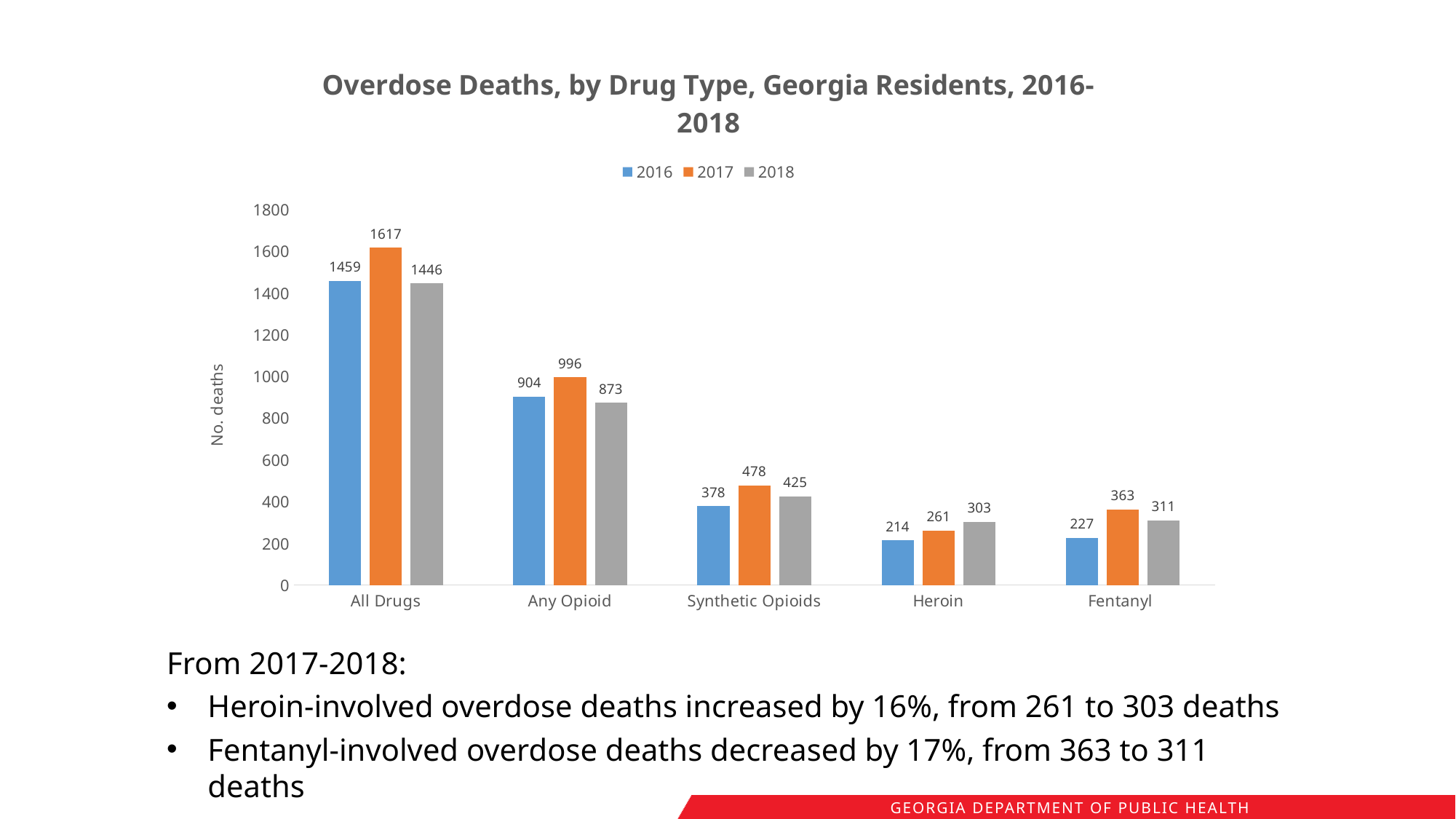
What is the number of overdose deaths for All Drugs in 2017? 1617 Which drug type has the lowest number of deaths in 2016? Heroin What kind of chart is shown on the slide? bar chart Which drug type has the highest number of deaths in 2018? All Drugs What is the label of the y axis? No. deaths Which is larger for Synthetic Opioids: the 2016 value or the 2018 value? 2018 What is the difference between the 2017 and 2018 values for Any Opioid? 123 How many series does the legend list? 3 What is the number of overdose deaths for Heroin in 2016? 214 What is the number of overdose deaths for Fentanyl in 2018? 311 How many drug type categories are shown on the x axis? 5 Is the value for Any Opioid in 2016 greater or less than 1000? less